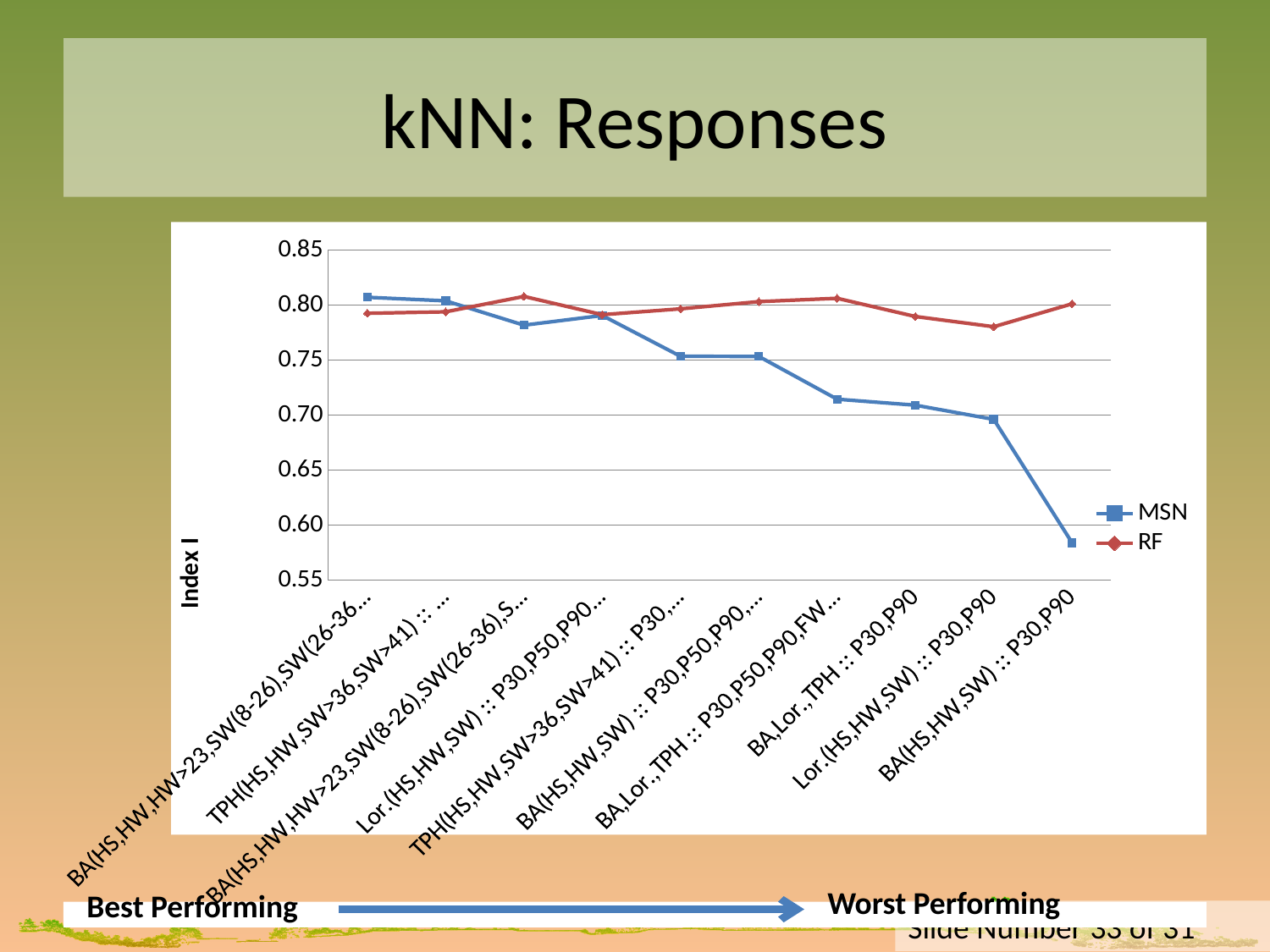
Is the MSN value for BA(HS,HW,SW) :: P30,P90 greater or less than 0.60? less What are the names of the series in the legend? MSN and RF How many categories are plotted along the x axis? 10 Does the MSN series generally rise or fall from left to right along the x axis? fall For which category is the MSN value lowest? BA(HS,HW,SW) :: P30,P90 Is the RF value for Lor.(HS,HW,SW) :: P30,P90 greater or less than 0.80? less Is the MSN value for BA,Lor.,TPH :: P30,P90 greater or less than 0.70? greater What kind of chart is shown on the slide? line chart How many series does the legend list? 2 For the category BA(HS,HW,SW) :: P30,P90, which series has the larger value, MSN or RF? RF What is the title of the vertical axis? Index I For the category Lor.(HS,HW,SW) :: P30,P90, which series has the larger value, MSN or RF? RF